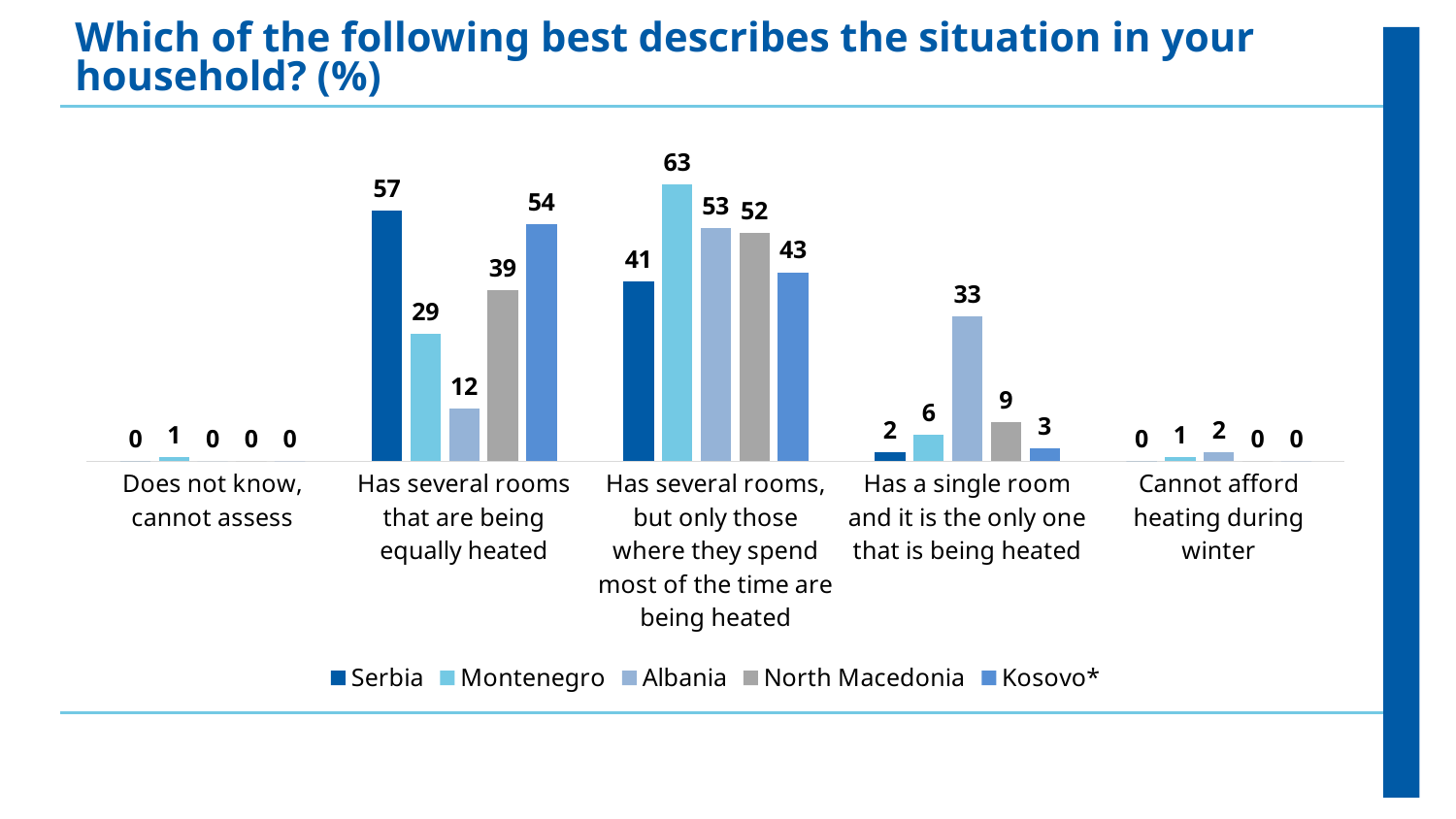
How many categories are shown on the x axis? 5 What kind of chart is shown on the slide? Bar chart Which series is listed last in the legend? Kosovo* Which is larger in the category 'Has several rooms, but only those where they spend most of the time are being heated': Albania or Kosovo*? Albania Which series has the lowest value in the category 'Has several rooms that are being equally heated'? Albania What is the value for Montenegro in the category 'Has several rooms, but only those where they spend most of the time are being heated'? 63 What is the value for Serbia in the category 'Has several rooms that are being equally heated'? 57 What is the value for Albania in the category 'Has a single room and it is the only one that is being heated'? 33 What is the difference between Kosovo* and North Macedonia in the category 'Has several rooms that are being equally heated'? 15 How many series does the legend list? 5 What is the value for Albania in the category 'Cannot afford heating during winter'? 2 Which series has the highest value in the category 'Has several rooms that are being equally heated'? Serbia